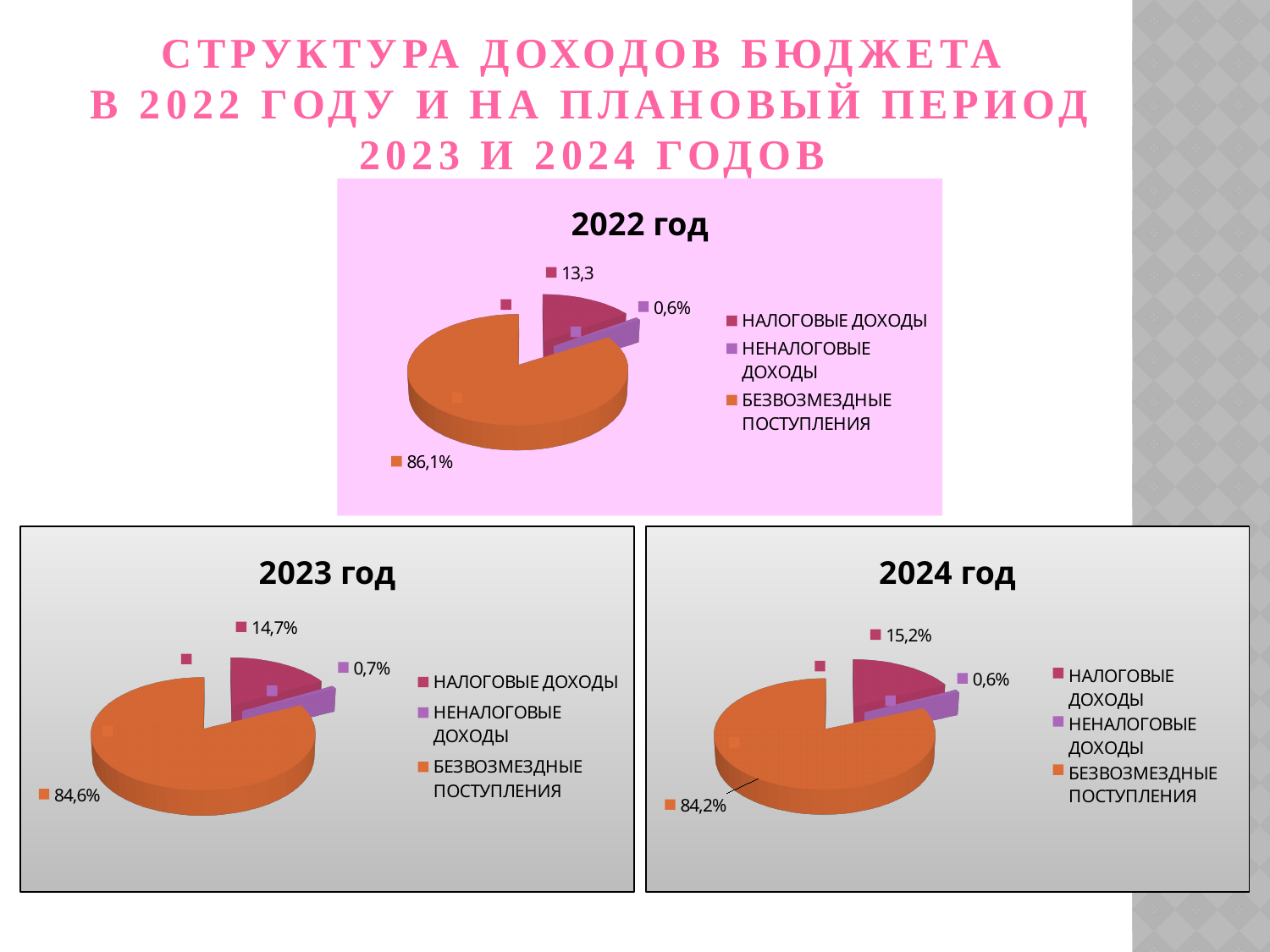
In the "2022 год" chart, what is the value shown for НАЛОГОВЫЕ ДОХОДЫ? 13,3 How many slices does the "2022 год" pie chart have? 3 In the "2022 год" chart, what is the value shown for БЕЗВОЗМЕЗДНЫЕ ПОСТУПЛЕНИЯ? 86,1% In the "2024 год" chart, what is the value shown for БЕЗВОЗМЕЗДНЫЕ ПОСТУПЛЕНИЯ? 84,2% In the "2024 год" chart, what is the value shown for НАЛОГОВЫЕ ДОХОДЫ? 15,2% In the "2023 год" chart, what is the value shown for НЕНАЛОГОВЫЕ ДОХОДЫ? 0,7% In the "2024 год" chart, which category has the smallest slice? НЕНАЛОГОВЫЕ ДОХОДЫ Which is larger: НАЛОГОВЫЕ ДОХОДЫ in the "2023 год" chart or НАЛОГОВЫЕ ДОХОДЫ in the "2024 год" chart? 2024 год What type of chart is the "2024 год" chart? Pie chart In the "2023 год" chart, what is the difference between the values for БЕЗВОЗМЕЗДНЫЕ ПОСТУПЛЕНИЯ and НАЛОГОВЫЕ ДОХОДЫ? 69,9% How many charts are shown on the slide? 3 In the "2023 год" chart, which category has the largest slice? БЕЗВОЗМЕЗДНЫЕ ПОСТУПЛЕНИЯ